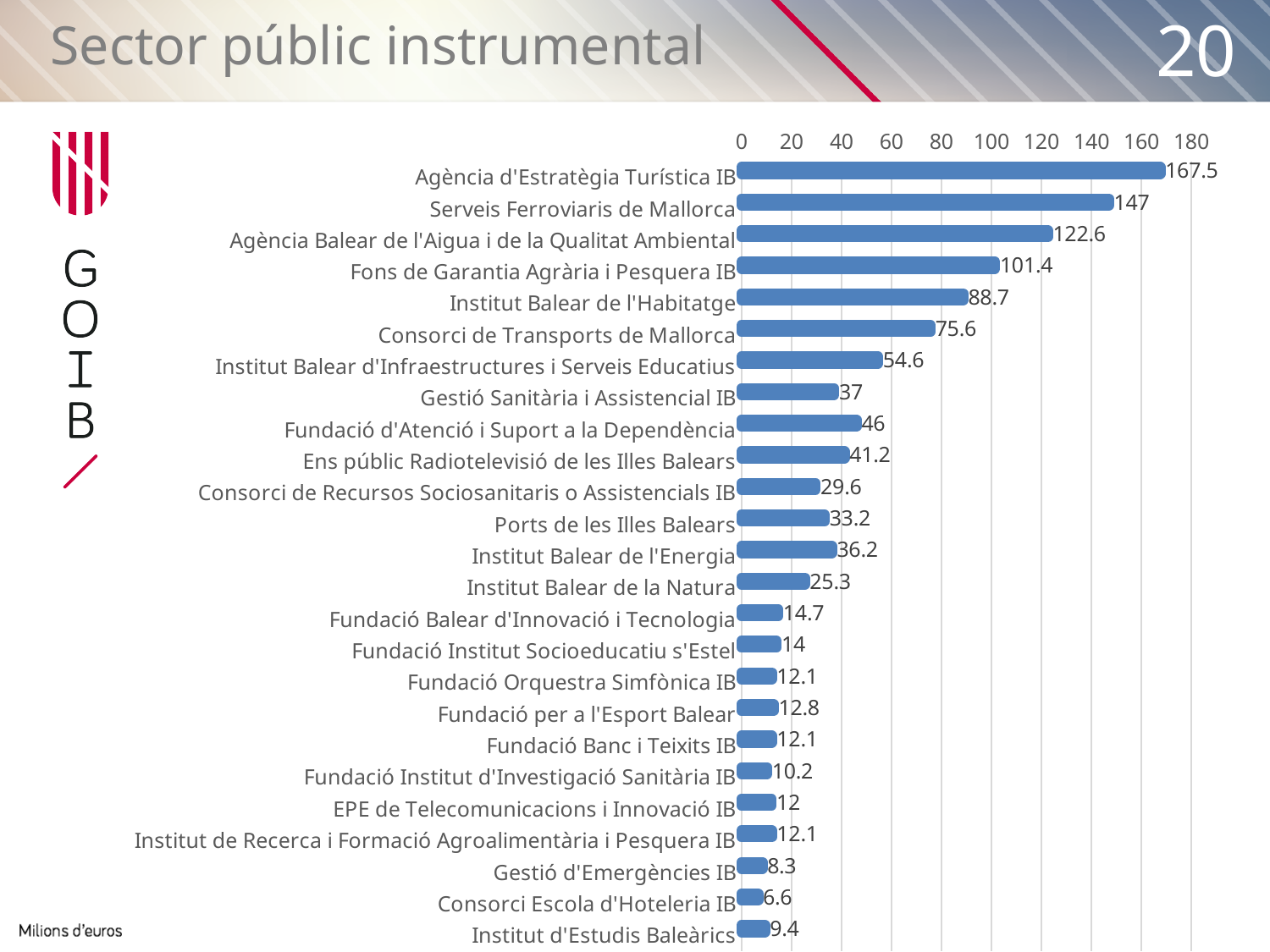
What is the value for Gestió d'Emergències IB? 8.3 Which is larger, the value for Ports de les Illes Balears or the value for Institut Balear de l'Energia? Institut Balear de l'Energia Which category has the highest value? Agència d'Estratègia Turística IB How many categories are shown in the chart? 25 What is the value for Consorci de Transports de Mallorca? 75.6 What is the difference between the values for Serveis Ferroviaris de Mallorca and Agència Balear de l'Aigua i de la Qualitat Ambiental? 24.4 What kind of chart is shown on the slide? bar chart What unit is indicated at the bottom left of the chart? Milions d'euros Which category has the lowest value? Consorci Escola d'Hoteleria IB What is the value for Institut Balear de l'Habitatge? 88.7 What is the value for Agència d'Estratègia Turística IB? 167.5 Is the value for Fons de Garantia Agrària i Pesquera IB greater or less than 100? greater